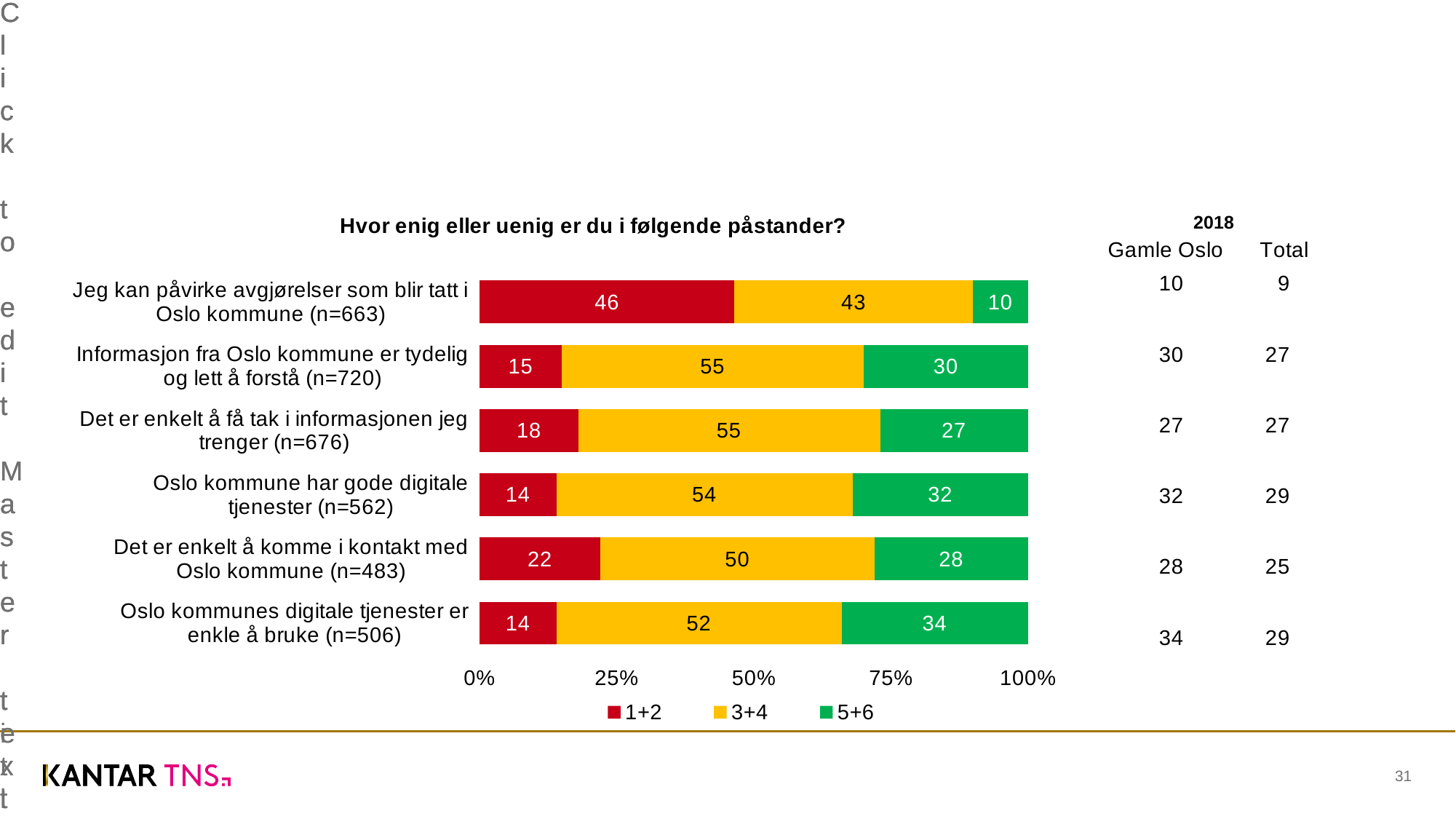
Which statement has the highest 1+2 value? Jeg kan påvirke avgjørelser som blir tatt i Oslo kommune What is the total of the stacked bar for "Informasjon fra Oslo kommune er tydelig og lett å forstå"? 100 What is the difference between the 5+6 values for "Oslo kommune har gode digitale tjenester" and "Det er enkelt å få tak i informasjonen jeg trenger"? 5 What is the value of the 1+2 segment for "Jeg kan påvirke avgjørelser som blir tatt i Oslo kommune"? 46 What is the value of the 3+4 segment for "Det er enkelt å komme i kontakt med Oslo kommune"? 50 How many series does the legend list? 3 What is the title of the chart? Hvor enig eller uenig er du i følgende påstander? Which is larger: the 1+2 value for "Det er enkelt å komme i kontakt med Oslo kommune" or for "Det er enkelt å få tak i informasjonen jeg trenger"? Det er enkelt å komme i kontakt med Oslo kommune What kind of chart is shown on the slide? Stacked bar chart How many statements (categories) are shown in the chart? 6 What is the value of the 5+6 segment for "Oslo kommunes digitale tjenester er enkle å bruke"? 34 Which statement has the lowest 5+6 value? Jeg kan påvirke avgjørelser som blir tatt i Oslo kommune